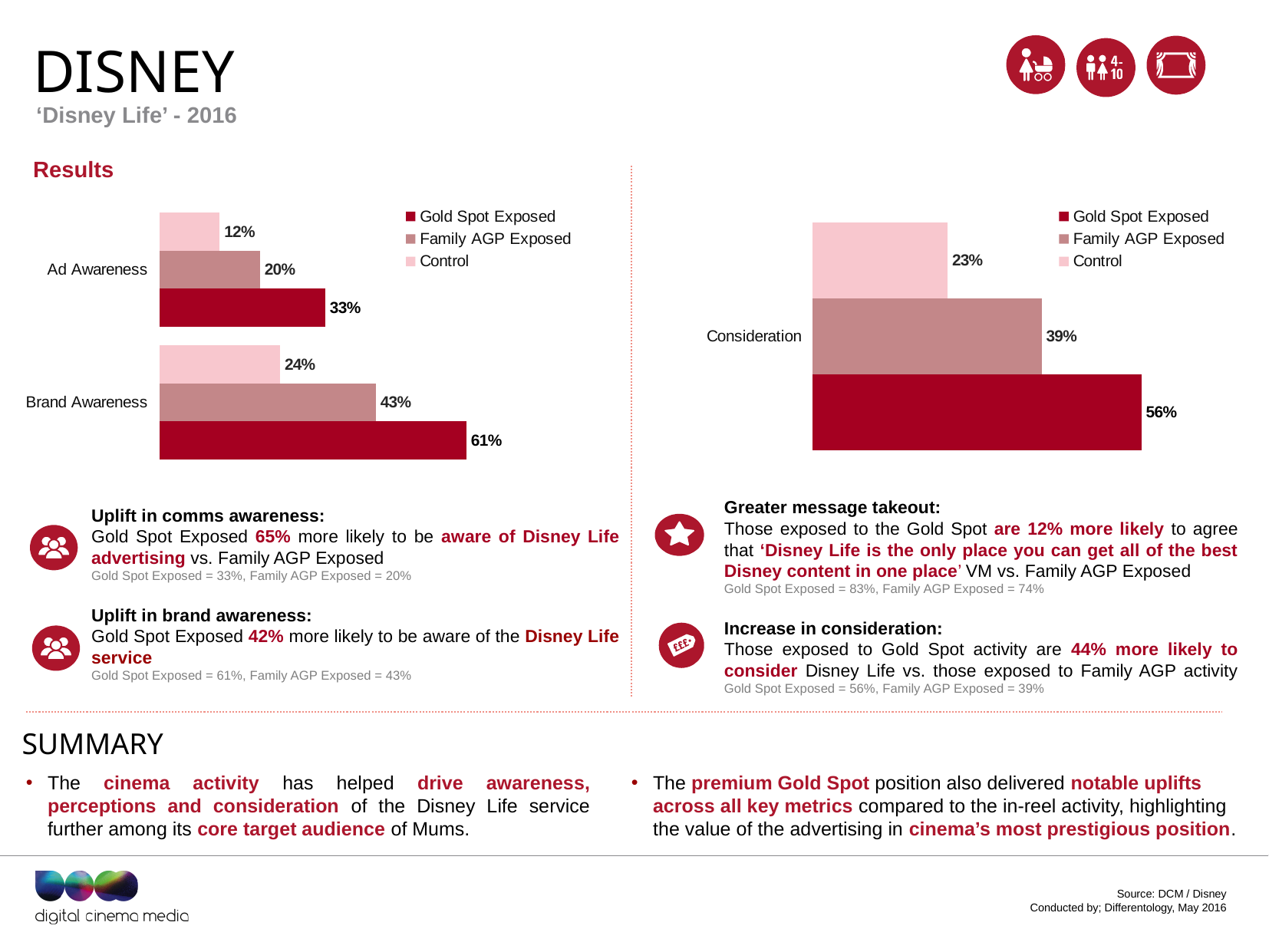
In the left chart, what is the Gold Spot Exposed value for Ad Awareness? 33% In the right chart, what is the Family AGP Exposed value for Consideration? 39% In the left chart, what is the Family AGP Exposed value for Brand Awareness? 43% In the right chart, what is the difference between the Gold Spot Exposed and Control values for Consideration? 33% What type of chart is the left chart? Bar chart In the right chart, which series has the highest value for Consideration? Gold Spot Exposed In the left chart, what is the difference between the Gold Spot Exposed and Family AGP Exposed values for Brand Awareness? 18% In the left chart, which is larger: the Control value for Brand Awareness or the Family AGP Exposed value for Ad Awareness? Control value for Brand Awareness How many series does the legend of the right chart list? 3 In the left chart, what is the Control value for Brand Awareness? 24% How many categories are shown in the left chart? 2 In the left chart, which series has the lowest value for Ad Awareness? Control